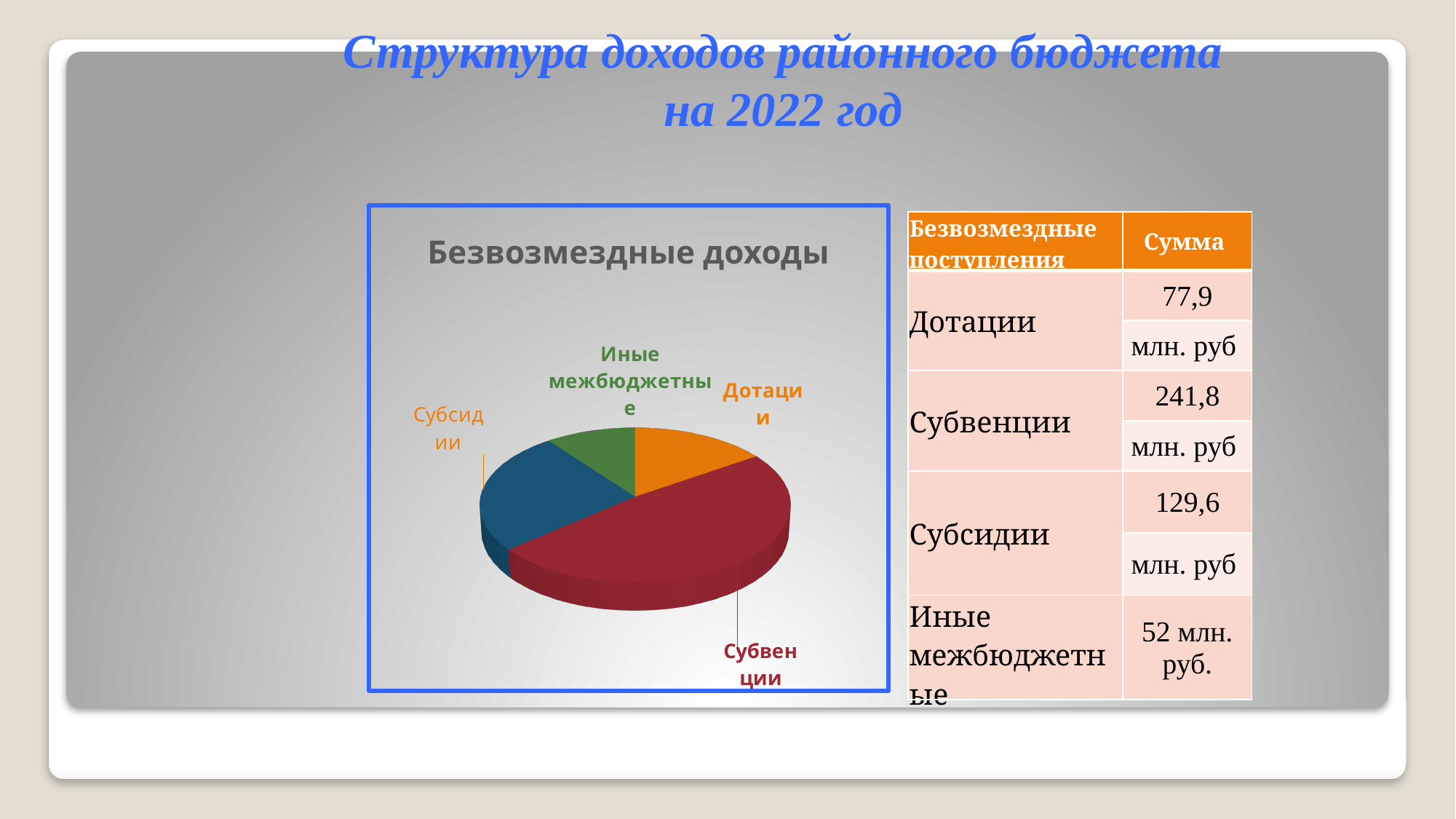
Which category has the smallest slice of the pie? Иные межбюджетные By how much does the amount for Субвенции exceed the amount for Субсидии (in млн. руб)? 112,2 According to the slide, what is the amount for Дотации? 77,9 млн. руб How many slices does the pie chart have? 4 According to the slide, what is the amount for Субсидии? 129,6 млн. руб What kind of chart is shown on the slide? Pie chart According to the slide, what is the amount for Субвенции? 241,8 млн. руб Which category has the largest slice of the pie? Субвенции What colour is the Субвенции slice of the pie? Red What is the title of the chart? Безвозмездные доходы According to the slide, what is the amount for Иные межбюджетные? 52 млн. руб. Which slice is larger, Субсидии or Дотации? Субсидии